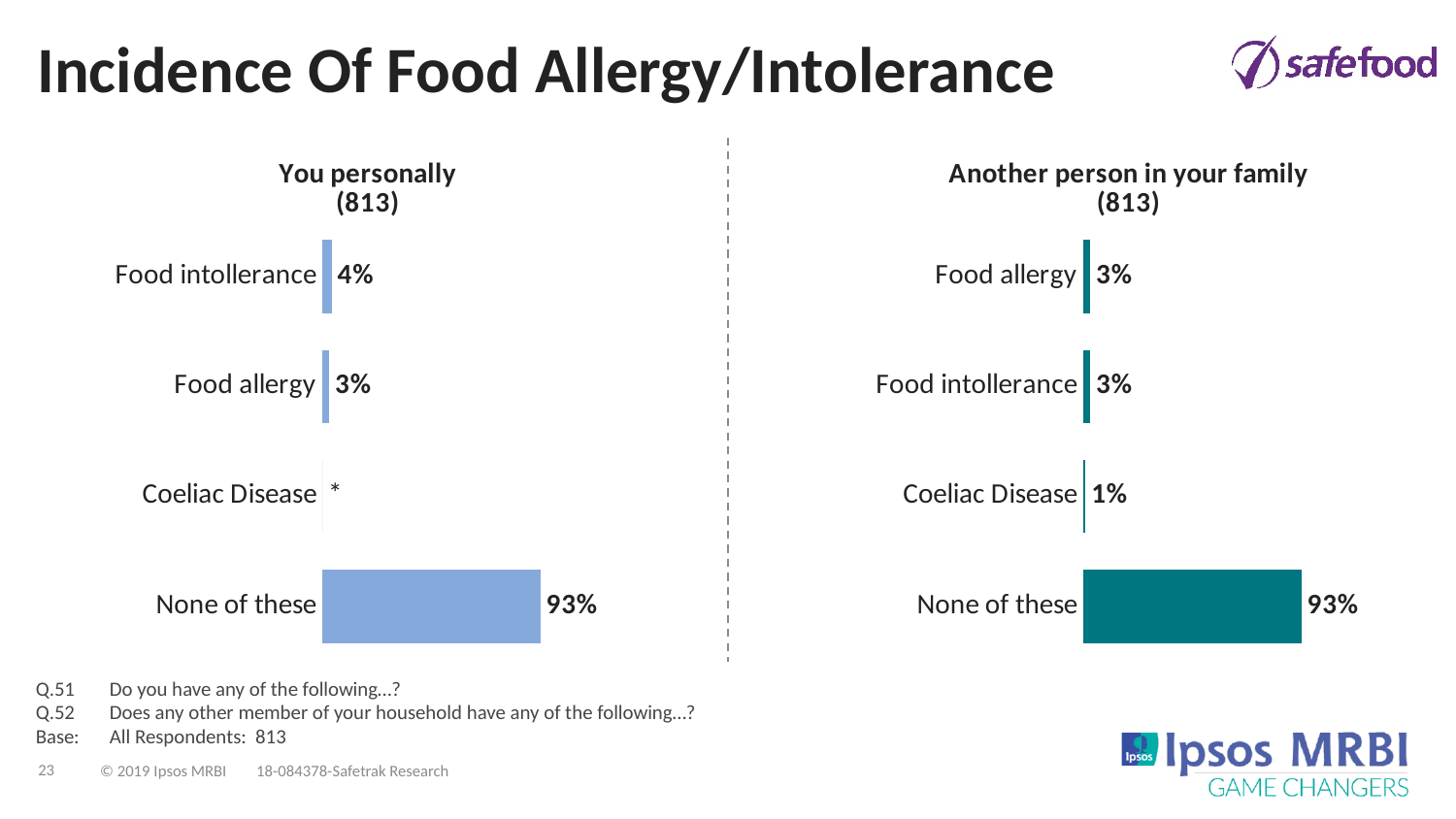
In the 'Another person in your family' chart, which category has the highest value? None of these In the 'You personally' chart, what is the value for Food allergy? 3% In the 'You personally' chart, which category has the highest value? None of these In the 'You personally' chart, what is the difference between None of these and Food intollerance? 89% In the 'Another person in your family' chart, what is the value for Food allergy? 3% In the 'You personally' chart, which is larger, Food intollerance or Food allergy? Food intollerance What is the base size shown under the 'Another person in your family' chart title? 813 In the 'You personally' chart, what is the value for Food intollerance? 4% In the 'You personally' chart, what is the value for None of these? 93% In the 'Another person in your family' chart, what is the value for Coeliac Disease? 1% What kind of chart is the 'You personally' chart? Bar chart How many categories are shown in the 'Another person in your family' chart? 4